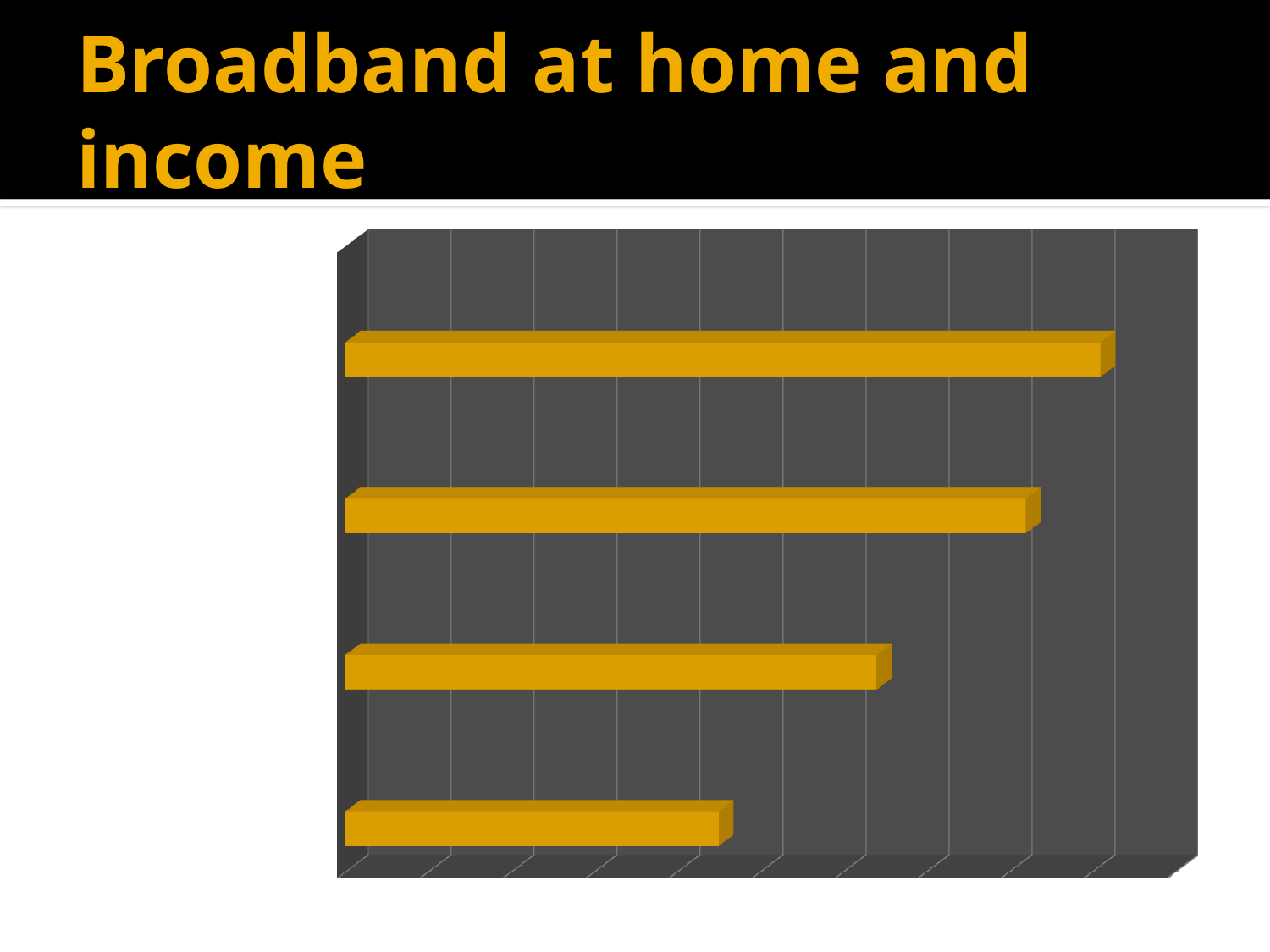
How many bars does the chart show? 4 Is the top bar longer or shorter than the bottom bar? longer Are the bars in the chart drawn horizontally or vertically? horizontally Do the bar lengths increase or decrease going from the top bar to the bottom bar? decrease Which bar in the chart is the shortest? the bottom bar What is the title of the slide containing the chart? Broadband at home and income What kind of chart is shown on the slide? bar chart Which bar in the chart is the longest, the top one or the bottom one? the top one Is the second bar from the top longer or shorter than the third bar from the top? longer